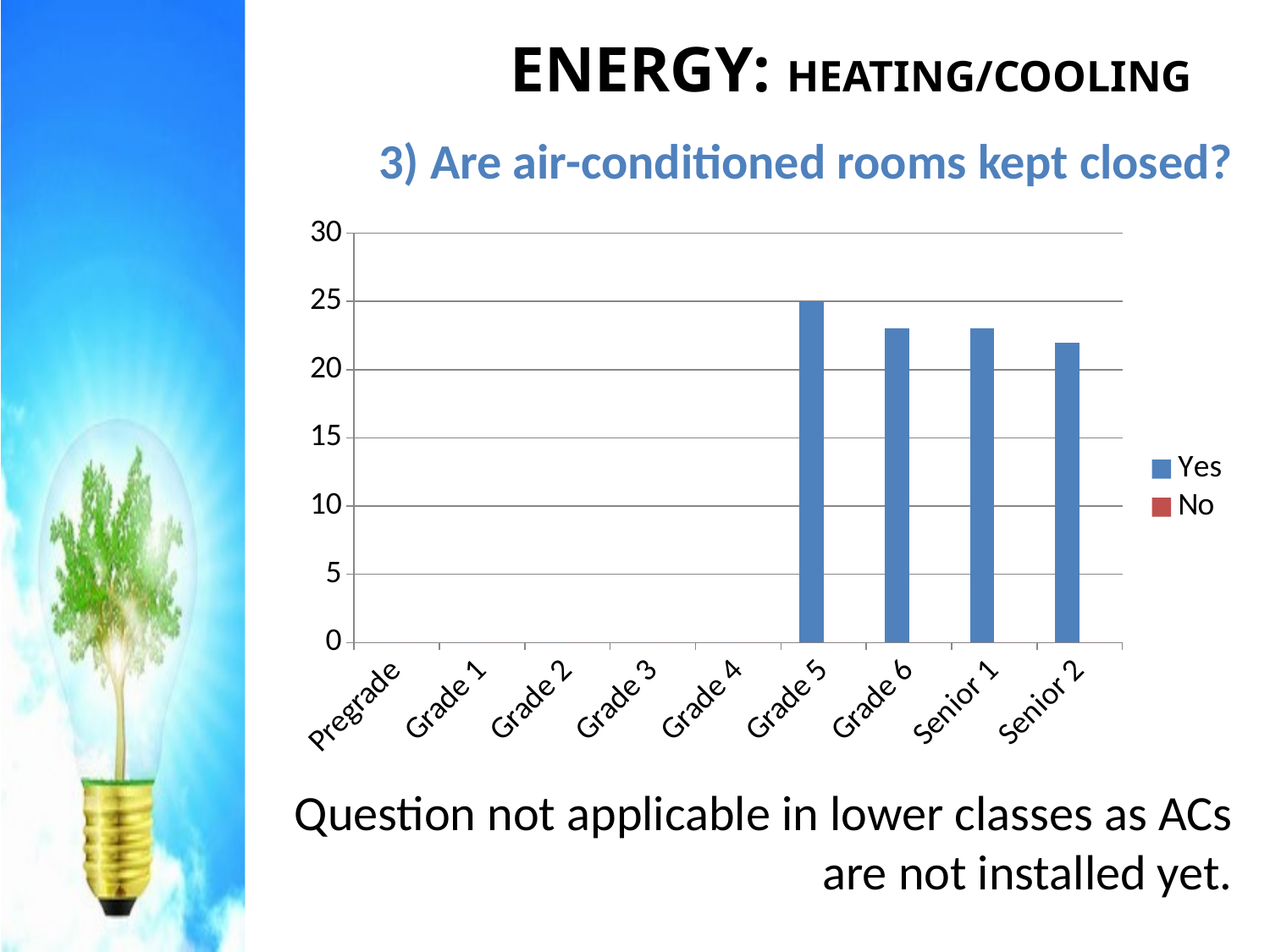
Is the Yes value for Senior 2 greater or less than 25? less Which category has the highest Yes bar? Grade 5 Which is larger, the Yes value for Grade 5 or for Senior 2? Grade 5 How many series does the legend list? 2 What type of chart is shown on the slide? bar chart How many categories are shown on the x axis? 9 How many categories have a visible bar plotted? 4 Is the Yes value for Senior 1 greater or less than 20? greater What question does the chart title ask? Are air-conditioned rooms kept closed? What is the value of the Yes bar for Grade 5? 25 Which series is shown in blue according to the legend? Yes Is the Yes value for Grade 6 greater or less than 20? greater